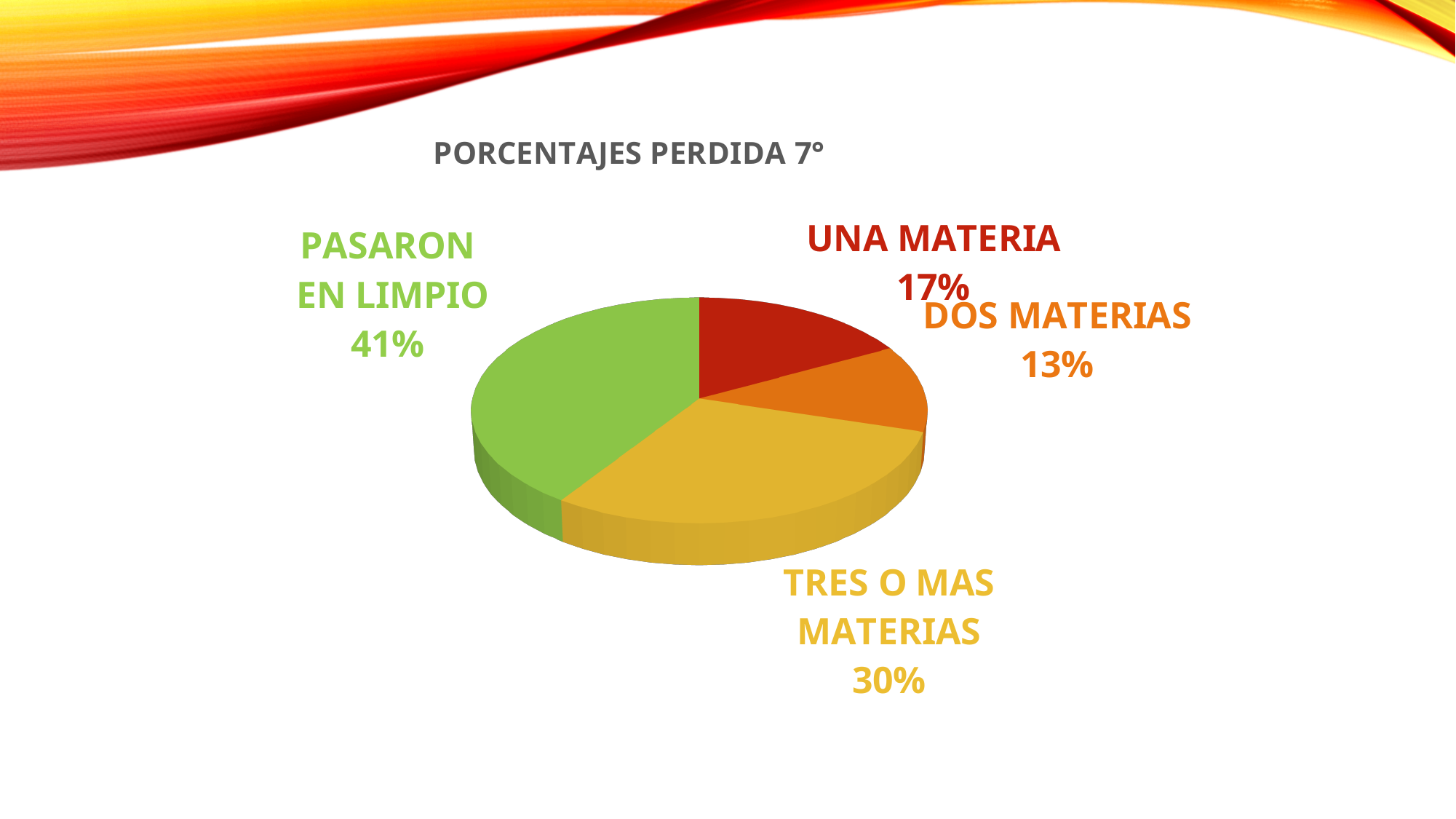
What percentage is shown for PASARON EN LIMPIO? 41% Which category has the smallest share of the pie? DOS MATERIAS What percentage is shown for UNA MATERIA? 17% What percentage is shown for TRES O MAS MATERIAS? 30% Which category has the largest share of the pie? PASARON EN LIMPIO What is the difference between the PASARON EN LIMPIO share and the TRES O MAS MATERIAS share? 11% Which is larger, the share for UNA MATERIA or the share for DOS MATERIAS? UNA MATERIA What percentage is shown for DOS MATERIAS? 13% What type of chart is shown on the slide? Pie chart What colour is the slice for TRES O MAS MATERIAS? Yellow How many slices does the pie chart have? 4 What is the title of the chart? PORCENTAJES PERDIDA 7°